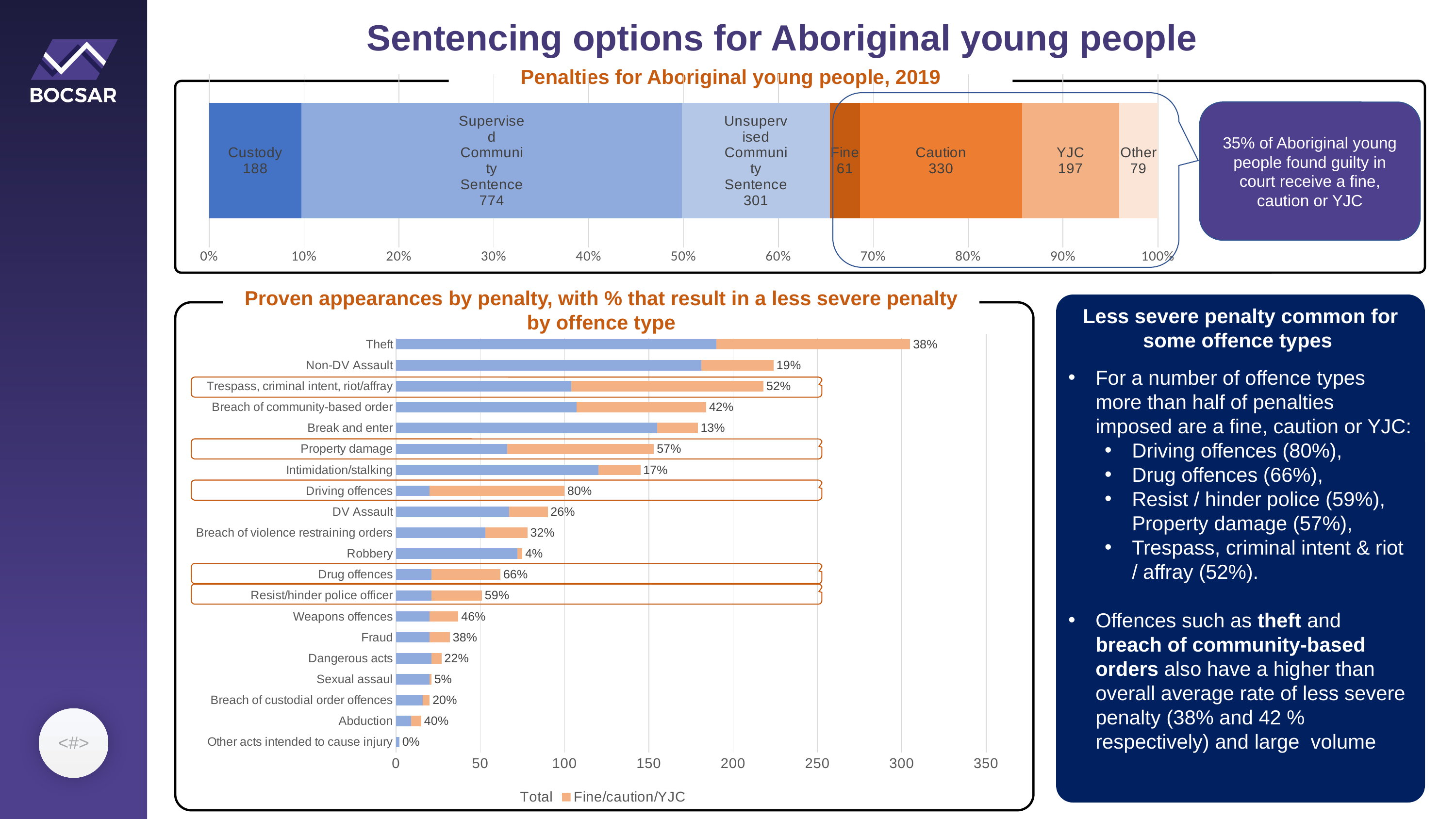
How many series does the legend of the chart 'Proven appearances by penalty, with % that result in a less severe penalty by offence type' list? 2 In the chart 'Penalties for Aboriginal young people, 2019', which is larger: Unsupervised Community Sentence or Caution? Caution In the chart 'Proven appearances by penalty, with % that result in a less severe penalty by offence type', which offence type has the longest total bar? Theft In the chart 'Proven appearances by penalty, with % that result in a less severe penalty by offence type', is the total bar for Theft greater or less than 250? greater In the chart 'Penalties for Aboriginal young people, 2019', which penalty has the highest value? Supervised Community Sentence How many offence types are listed in the chart 'Proven appearances by penalty, with % that result in a less severe penalty by offence type'? 20 In the chart 'Penalties for Aboriginal young people, 2019', which penalty has the lowest value? Fine In the chart 'Penalties for Aboriginal young people, 2019', what is the value for Caution? 330 In the chart 'Penalties for Aboriginal young people, 2019', what is the value for Custody? 188 In the chart 'Proven appearances by penalty, with % that result in a less severe penalty by offence type', what percentage is shown for Breach of community-based order? 42% In the chart 'Proven appearances by penalty, with % that result in a less severe penalty by offence type', what percentage is shown for Driving offences? 80% In the chart 'Penalties for Aboriginal young people, 2019', what is the difference between the YJC value and the Other value? 118